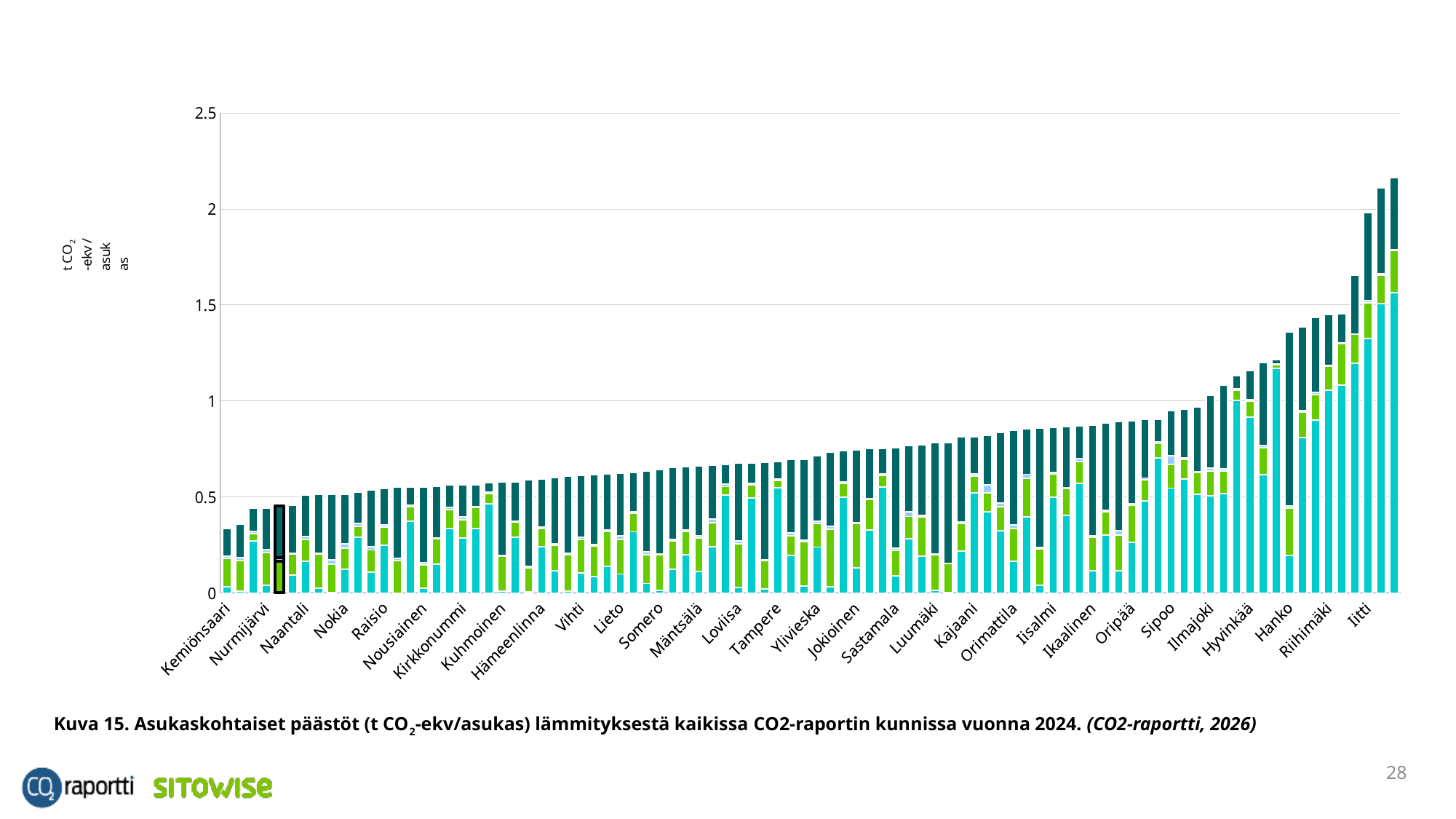
Do the bar values rise or fall from left to right along the x axis? rise What kind of chart is shown on the slide? bar chart Which has the larger value, Hanko or Kemiönsaari? Hanko Is the value for Kemiönsaari greater or less than 0.5? less Is the value for Hyvinkää greater or less than 1? greater Which year does the chart caption say the emissions are for? 2024 Is the value for Hämeenlinna greater or less than 0.5? greater Which municipality has the lowest per-capita heating emissions on the chart? Kemiönsaari Which has the larger value, Tampere or Hyvinkää? Hyvinkää